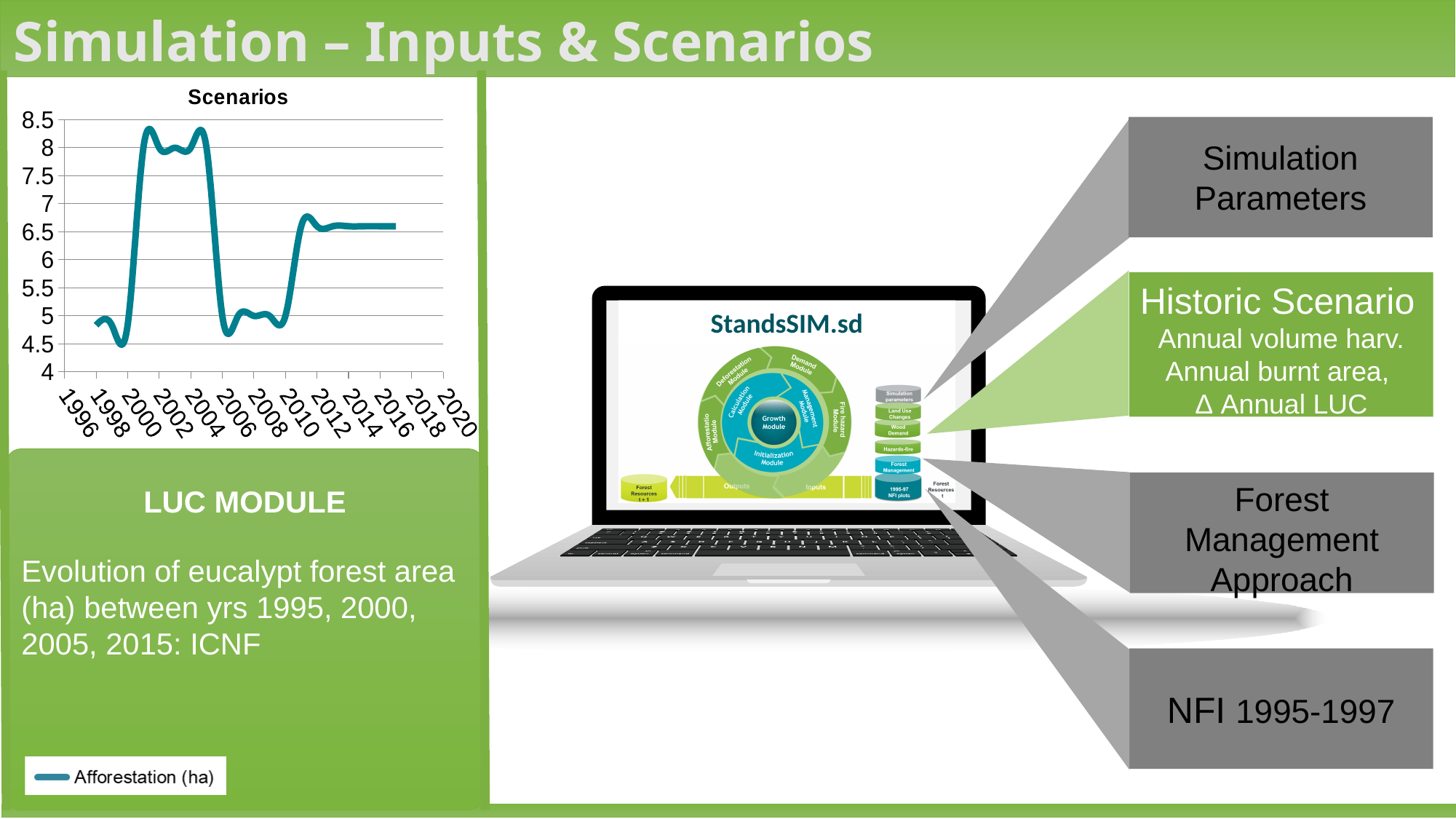
In the Scenarios chart, is the value for Afforestation (ha) around 2014 greater or less than 6? greater In the Scenarios chart, is the Afforestation (ha) value around 2002 larger or smaller than the value around 2012? larger In the Scenarios chart, does the Afforestation (ha) line rise or fall between 2004 and 2006? fall In the Scenarios chart, is the value for Afforestation (ha) around 1998 greater or less than 5? less How many series does the legend of the Scenarios chart list? 1 In the Scenarios chart, is the value for Afforestation (ha) around 2002 greater or less than 7.5? greater What is the title of the chart on the left of the slide? Scenarios What kind of chart is shown under the title "Scenarios"? line chart What series name appears in the legend of the Scenarios chart? Afforestation (ha) How many year labels are shown on the x axis of the Scenarios chart? 13